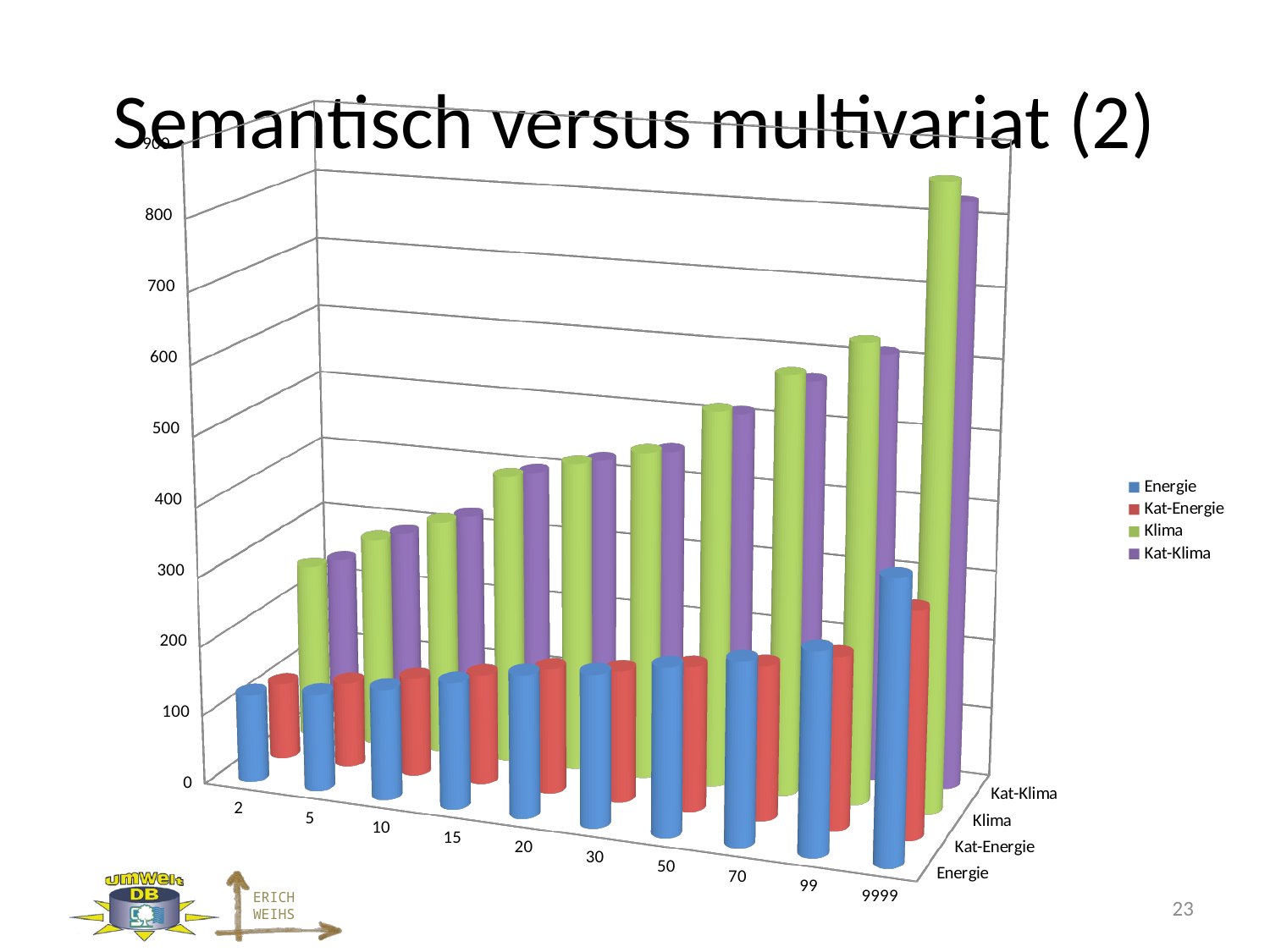
Which is larger at category 9999, the Klima value or the Energie value? Klima Is the Klima value for category 9999 greater or less than 500? greater How many categories are shown along the x axis of the chart? 10 Do the values of the Klima series rise or fall from category 2 to category 9999? rise For which category is the Klima series highest? 9999 What kind of chart is shown on the slide? bar chart Which is larger, the Klima value for category 9999 or the Klima value for category 2? 9999 Is the Energie value for category 2 greater or less than 300? less For which category is the Klima series lowest? 2 What is the title of the slide containing the chart? Semantisch versus multivariat (2) Which series are listed in the chart legend? Energie, Kat-Energie, Klima, Kat-Klima How many series does the chart legend list? 4